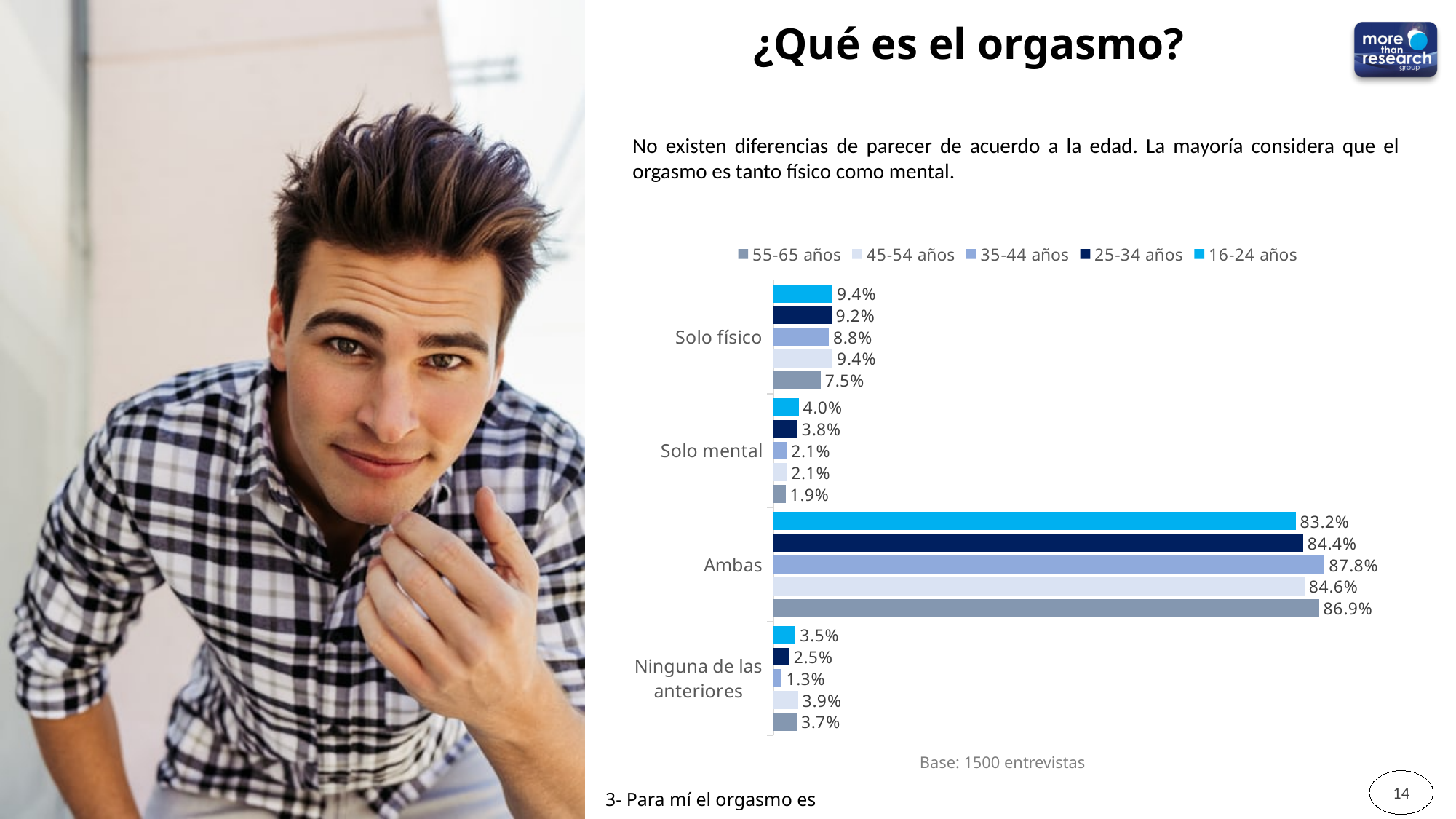
What is the value for 'Solo mental' in the 16-24 años series? 4.0% What is the value for 'Ambas' in the 35-44 años series? 87.8% How many age-group series does the legend list? 5 What is the value for 'Solo físico' in the 55-65 años series? 7.5% How many categories are shown on the chart? 4 What is the base (number of interviews) stated below the chart? 1500 entrevistas Which is larger for 'Solo mental': the 25-34 años value or the 55-65 años value? 25-34 años What is the value for 'Ninguna de las anteriores' in the 45-54 años series? 3.9% What is the difference between the 35-44 años and 16-24 años values for 'Ambas'? 4.6% What kind of chart is shown on the slide? Bar chart Which age group has the highest value for 'Ambas'? 35-44 años Which age group has the lowest value for 'Ninguna de las anteriores'? 35-44 años